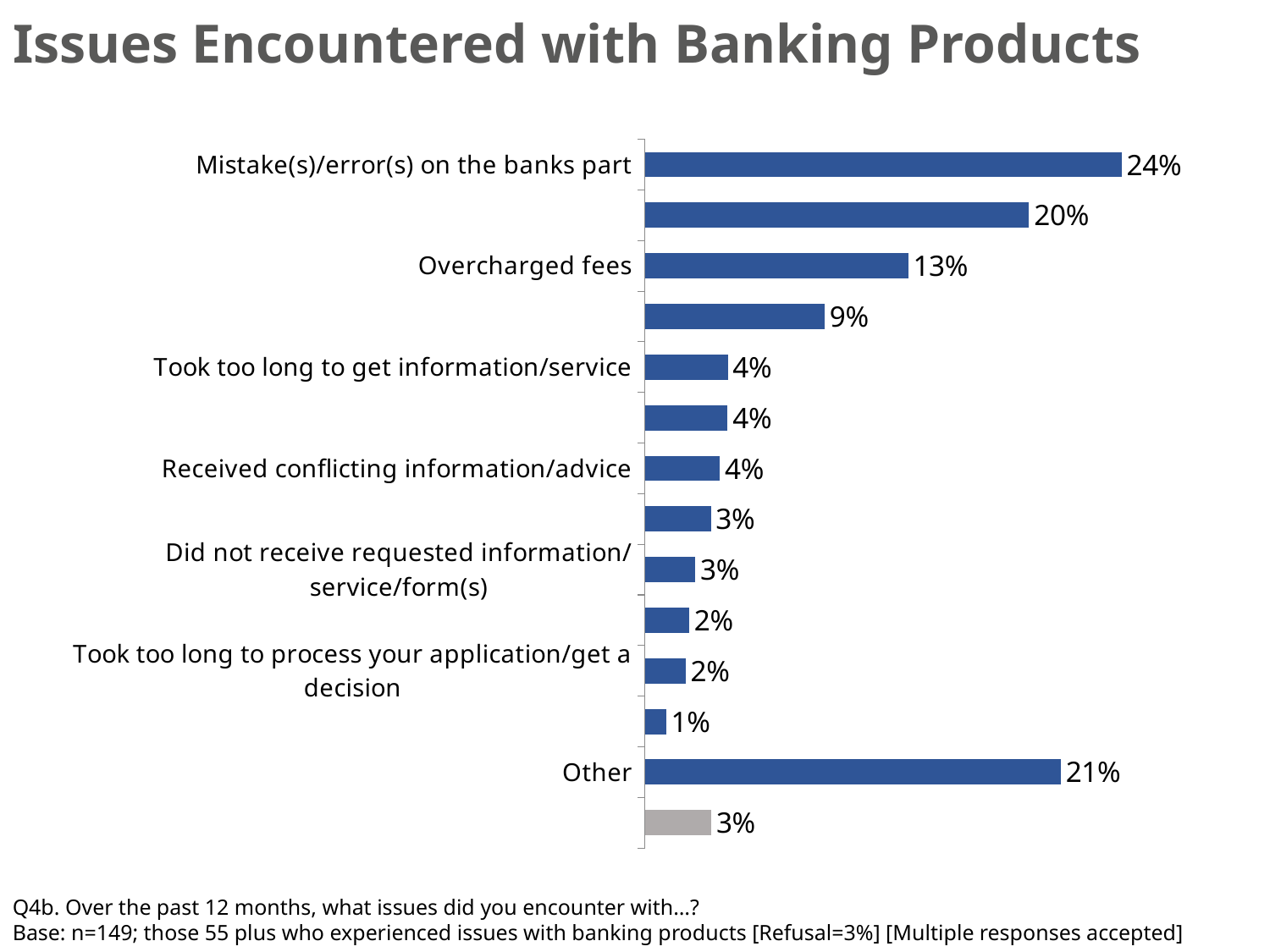
What is the value for Took too long to process your application/get a decision? 2% What is the value for Other? 21% What is the value for Mistake(s)/error(s) on the banks part? 24% What is the value for Overcharged fees? 13% What is the difference between Mistake(s)/error(s) on the banks part and Overcharged fees? 11 percentage points What is the value for Did not receive requested information/service/form(s)? 3% Which is larger, Overcharged fees or Other? Other What is the difference between Other and Overcharged fees? 8 percentage points Which labelled category has the highest value? Mistake(s)/error(s) on the banks part How many bars are plotted in the chart? 14 What is the smallest value shown on any bar in the chart? 1% What kind of chart is shown on the slide? Bar chart